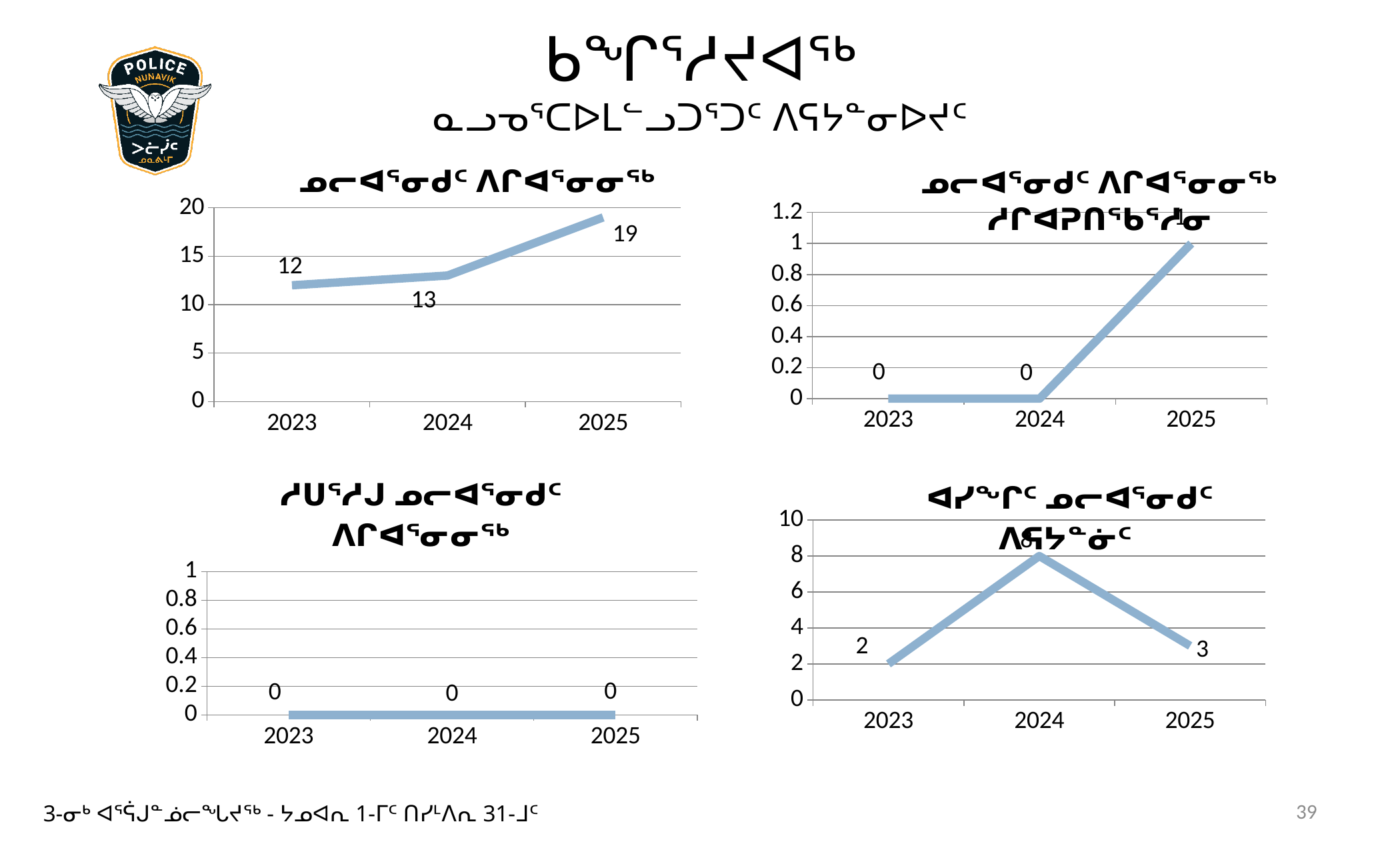
In the bottom-right chart, is the value for 2024 greater or less than 6? greater In the top-left chart, what is the value for 2023? 12 In the bottom-left chart, what is the value for 2025? 0 In the bottom-right chart, what is the value for 2023? 2 In the top-left chart, which year has the highest value? 2025 In the top-left chart, what is the value for 2025? 19 In the top-left chart, do the values rise or fall from 2023 to 2025? rise How many years are plotted on the x axis of the bottom-left chart? 3 What kind of chart is the bottom-right chart? line chart In the top-right chart, is the value for 2025 greater or less than 0.8? greater In the top-left chart, what is the difference between the 2025 and 2024 values? 6 In the top-right chart, what is the value for 2024? 0